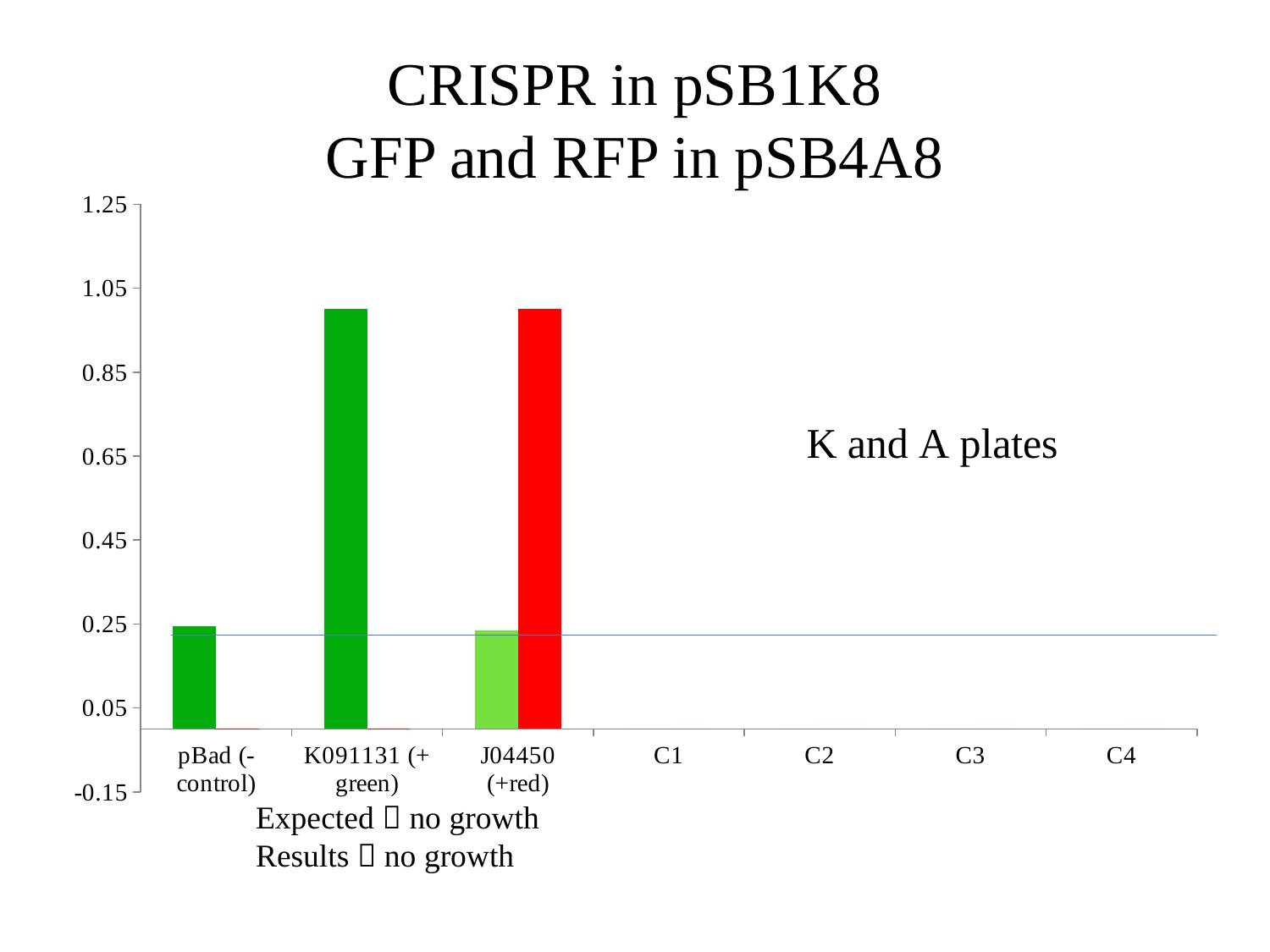
Is the value for pBad (- control) greater or less than 0.05? greater Is the value of the light green bar for J04450 (+red) greater or less than 0.45? less Is the value of the red bar for J04450 (+red) greater or less than 0.65? greater Which is larger, the red bar for J04450 (+red) or the light green bar for J04450 (+red)? the red bar What is the highest tick value shown on the y axis? 1.25 Which is larger, the value for K091131 (+ green) or the value for pBad (- control)? K091131 (+ green) How many categories are labelled on the x axis of the chart? 7 Which categories on the x axis have no bars plotted? C1, C2, C3, C4 What kind of chart is shown on the slide? bar chart